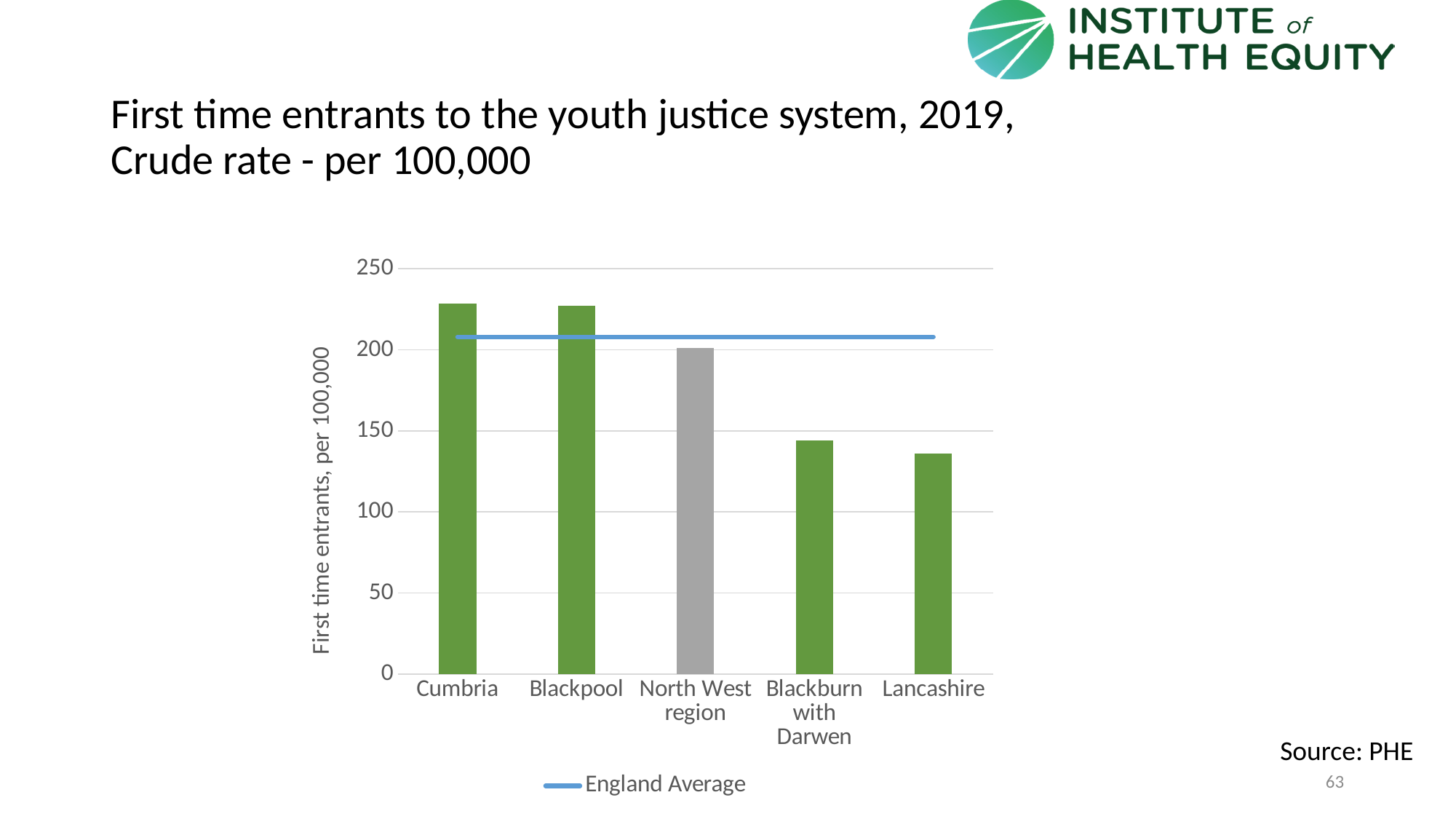
Which is larger, the value for Blackpool or the value for Blackburn with Darwen? Blackpool How many categories are shown on the x axis of the chart? 5 Is the value for Blackburn with Darwen greater or less than 150? less How many series does the chart's legend list? 1 Which is larger, the value for North West region or the value for Lancashire? North West region Is the value for Lancashire greater or less than 150? less Which category has the lowest rate of first time entrants? Lancashire Is the England Average line greater or less than 200? greater What kind of chart is shown on the slide? Bar chart Which category is shown with a grey bar instead of a green one? North West region Do the bar values generally rise or fall from left to right along the x axis? Fall